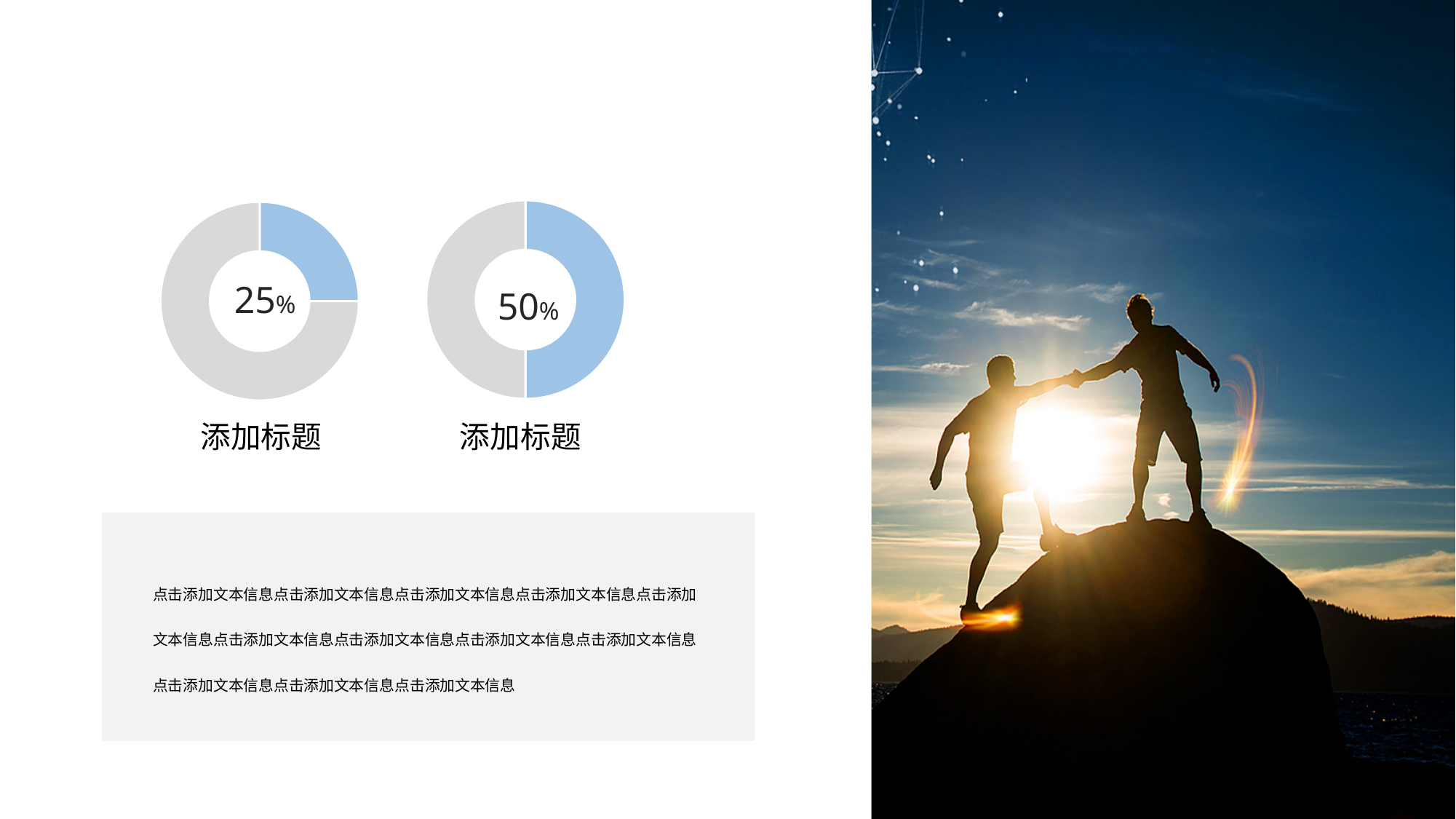
What percentage is shown in the centre of the right donut chart? 50% Which donut chart shows the larger percentage, the left one or the right one? the right one What percentage is shown in the centre of the left donut chart? 25% What colour is used for the filled portion of the donut charts? blue In the left donut chart, what share of the ring is filled in blue? 25% In the right donut chart, what share of the ring is filled in blue? 50% What is the title text shown below each donut chart? 添加标题 How many donut charts are on the slide? 2 What kind of chart is used on the left side of the slide? donut chart What is the difference between the percentage in the right donut chart and the percentage in the left donut chart? 25% Is the value shown in the left donut chart greater or less than 50%? less